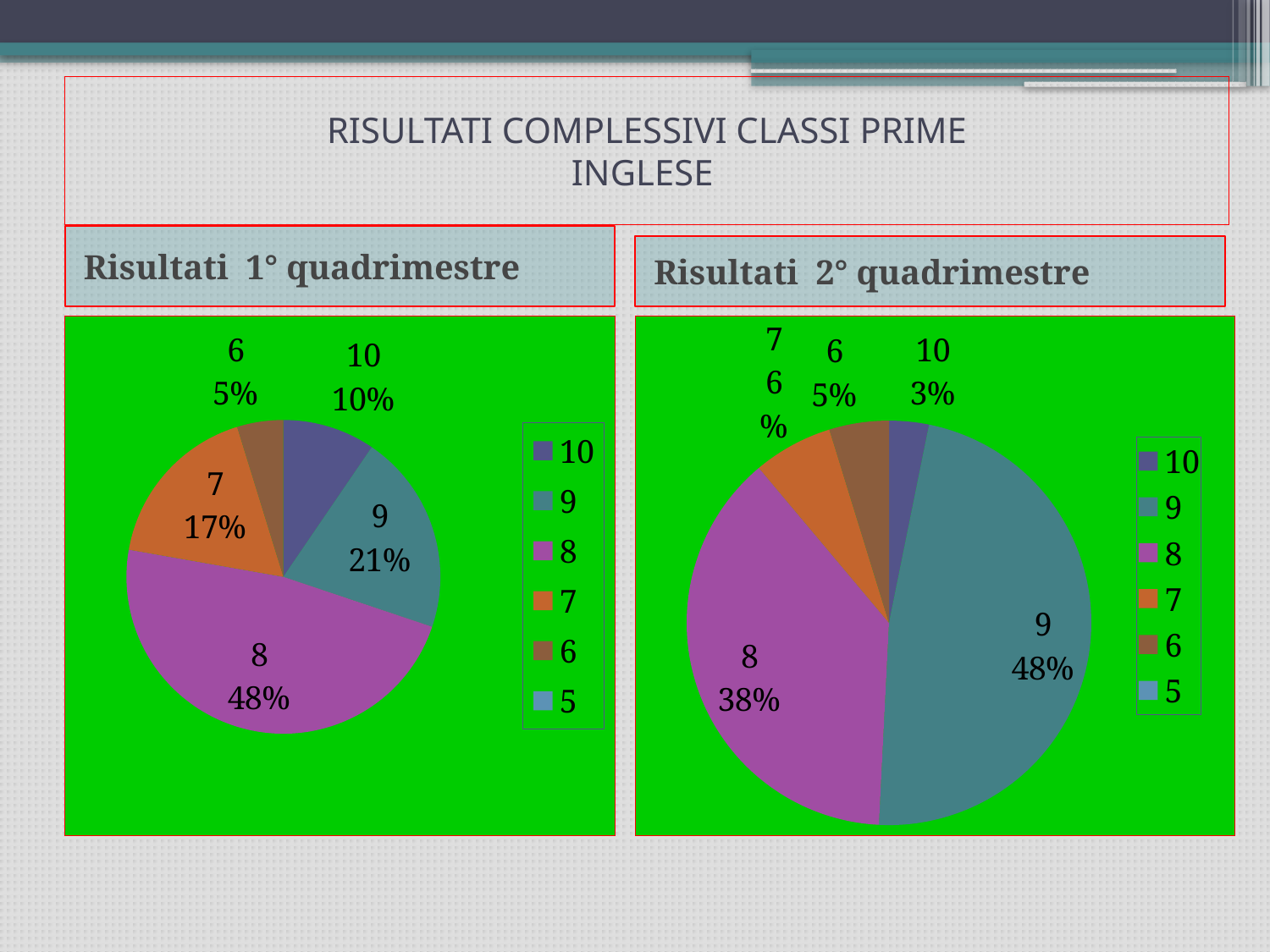
In the 'Risultati 1° quadrimestre' chart, what is the difference between the shares of grade 8 and grade 9? 27% In the 'Risultati 2° quadrimestre' chart, what share does grade 10 have? 3% What kind of chart is 'Risultati 2° quadrimestre'? pie chart In the 'Risultati 2° quadrimestre' chart, what is the difference between the shares of grade 9 and grade 8? 10% In the 'Risultati 1° quadrimestre' chart, which is larger: the share of grade 7 or the share of grade 10? 7 In the 'Risultati 2° quadrimestre' chart, which grade has the smallest slice? 10 In the 'Risultati 1° quadrimestre' chart, which grade has the largest slice? 8 In the 'Risultati 2° quadrimestre' chart, what share does grade 9 have? 48% What is the title of the slide above the two charts? RISULTATI COMPLESSIVI CLASSI PRIME INGLESE In the 'Risultati 1° quadrimestre' chart, what share does grade 8 have? 48% How many entries does the legend of the 'Risultati 1° quadrimestre' chart list? 6